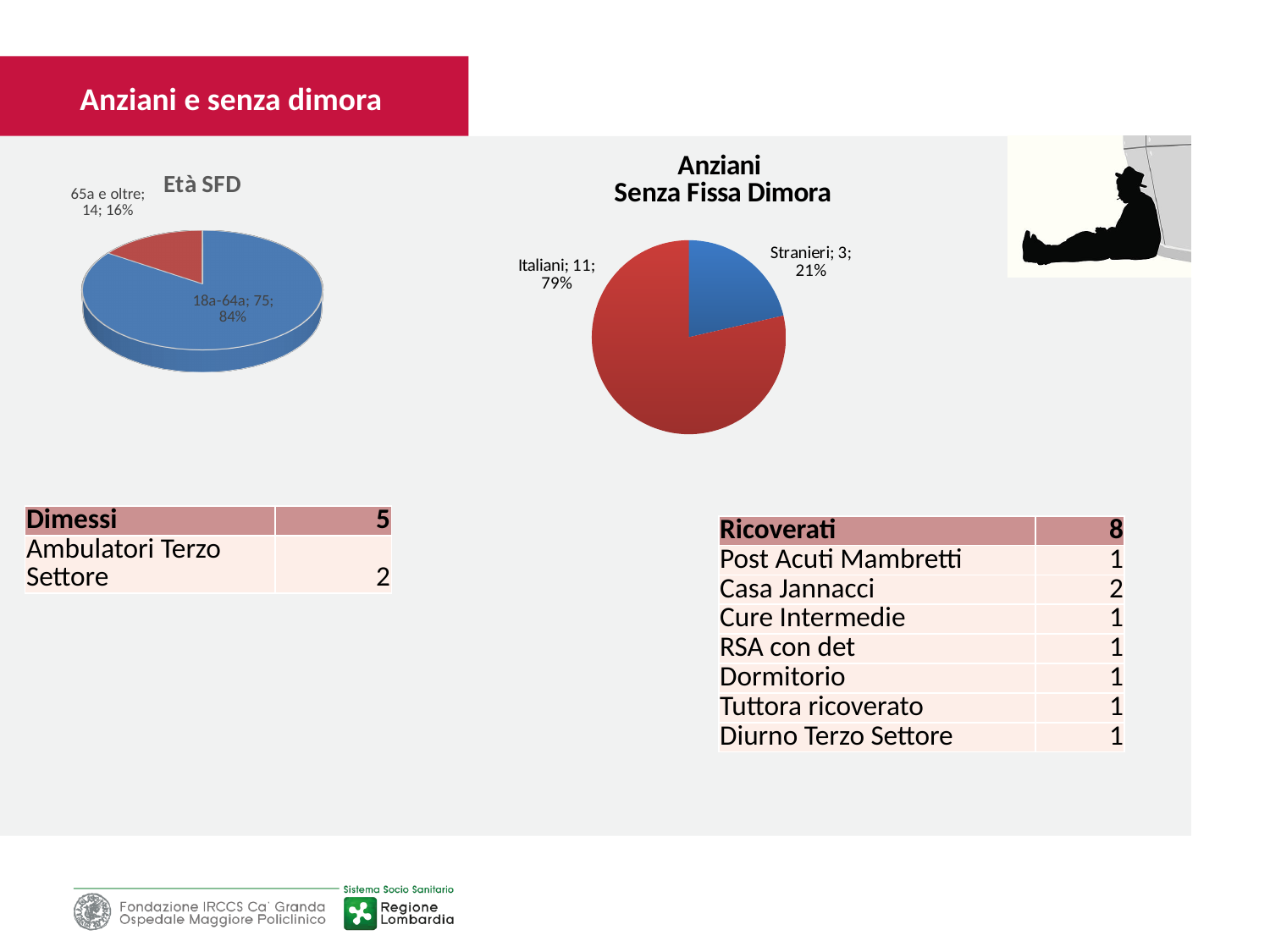
In the 'Età SFD' chart, what percentage share does the 65a e oltre slice have? 16% In the 'Anziani Senza Fissa Dimora' chart, which category is the smallest? Stranieri In the 'Anziani Senza Fissa Dimora' chart, what is the value for Stranieri? 3 In the 'Anziani Senza Fissa Dimora' chart, what colour is the Italiani slice? Red How many slices does the 'Età SFD' chart have? 2 In the 'Anziani Senza Fissa Dimora' chart, what is the total of the Italiani and Stranieri values? 14 In the 'Età SFD' chart, which category is the largest? 18a-64a In the 'Anziani Senza Fissa Dimora' chart, which is larger, Italiani or Stranieri? Italiani In the 'Anziani Senza Fissa Dimora' chart, what percentage share does the Italiani slice have? 79% In the 'Età SFD' chart, what is the value for the 18a-64a slice? 75 In the 'Età SFD' chart, what is the difference between the 18a-64a value and the 65a e oltre value? 61 What kind of chart is the 'Età SFD' chart? Pie chart